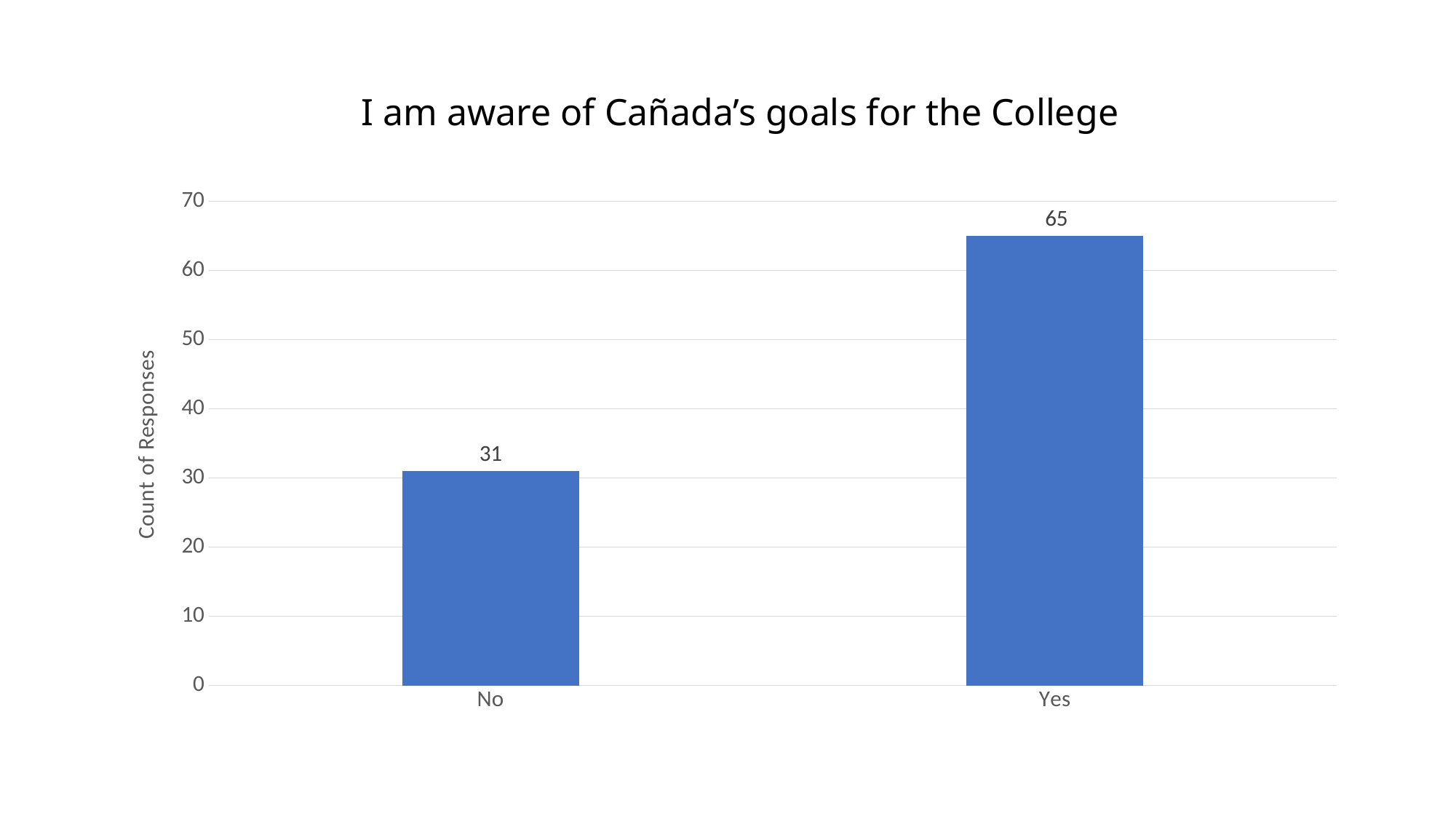
What is the label of the vertical axis? Count of Responses What is the title of the chart? I am aware of Cañada's goals for the College Is the value for "Yes" greater or less than 60? greater How many categories are shown on the x axis? 2 Which category has the lowest count of responses? No What kind of chart is shown on the slide? bar chart What is the difference between the counts for "Yes" and "No"? 34 Which category has the highest count of responses? Yes Is the value for "No" greater or less than 40? less What is the count of responses for "No"? 31 What is the count of responses for "Yes"? 65 Which has more responses, "Yes" or "No"? Yes